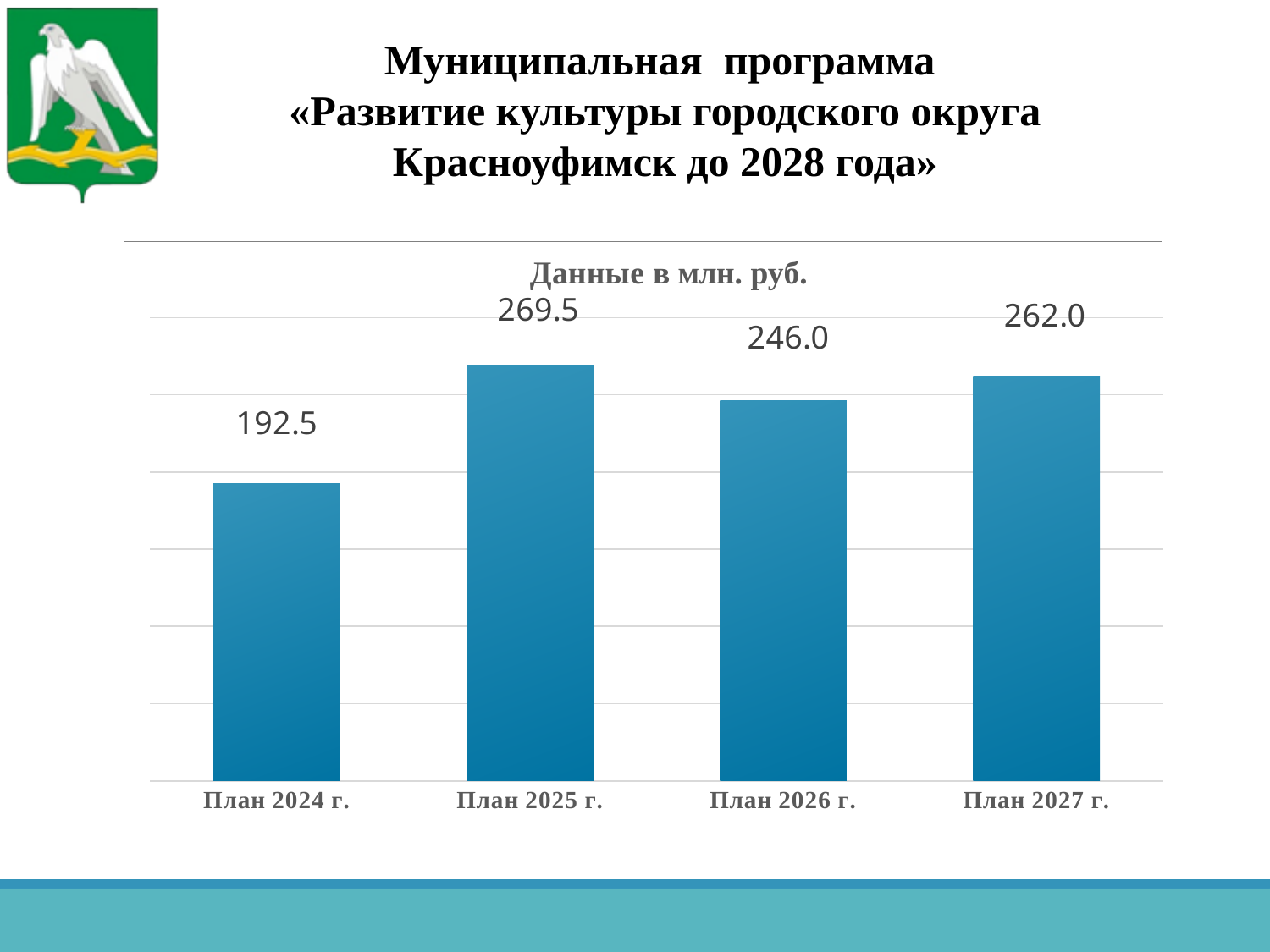
Which category has the highest value? План 2025 г. What is the value for План 2026 г.? 246.0 What is the title of the chart? Данные в млн. руб. What kind of chart is shown on the slide? Bar chart Which is larger, the value for План 2026 г. or the value for План 2027 г.? План 2027 г. Which category has the lowest value? План 2024 г. What is the value for План 2027 г.? 262.0 How many categories are shown on the chart? 4 What is the value for План 2024 г.? 192.5 What is the difference between the values for План 2027 г. and План 2026 г.? 16.0 What is the value for План 2025 г.? 269.5 What is the difference between the values for План 2025 г. and План 2024 г.? 77.0